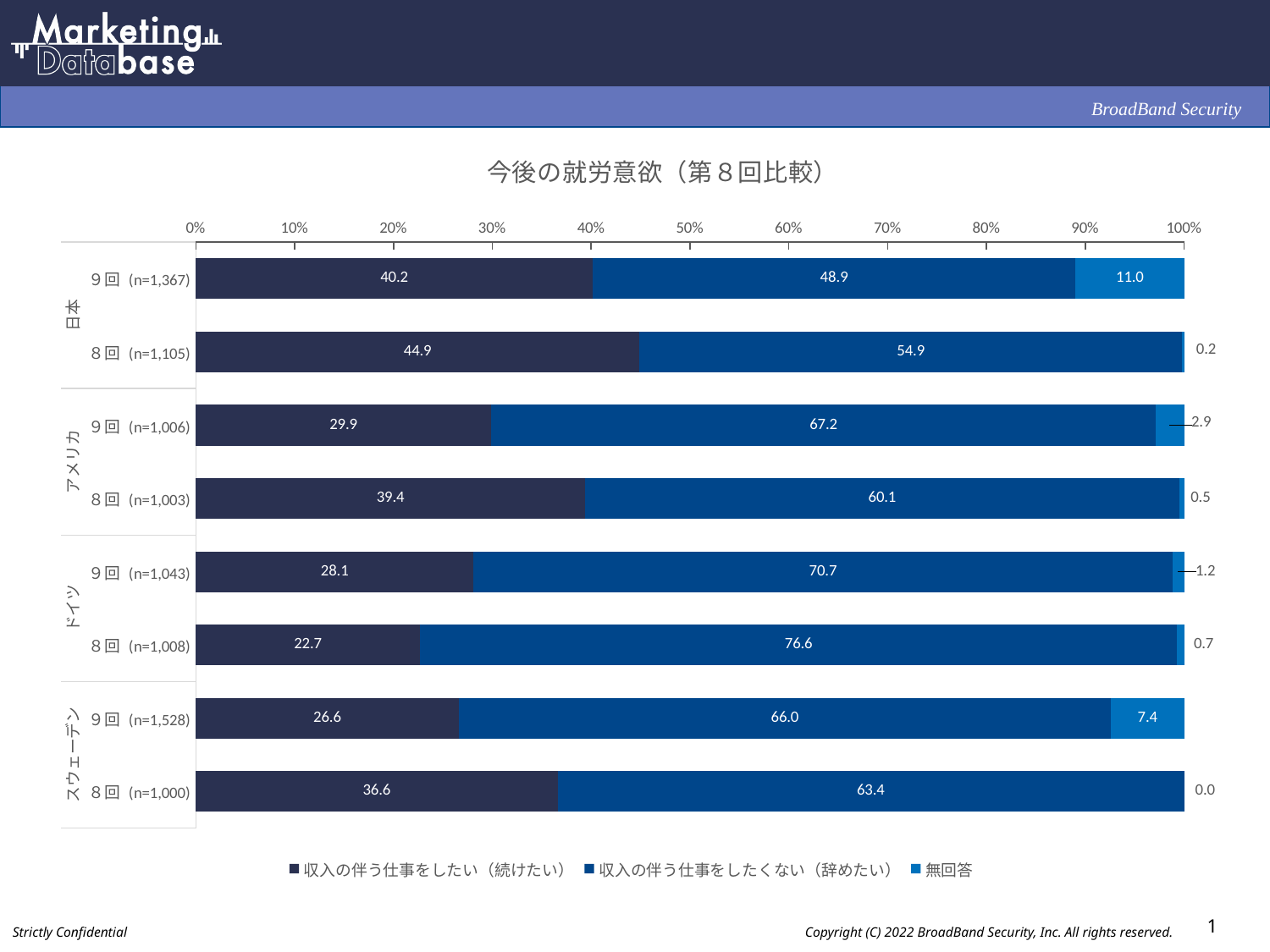
What is the value of 無回答 for スウェーデン 9回 (n=1,528)? 7.4 What is the difference in 収入の伴う仕事をしたい（続けたい） between 日本 8回 (n=1,105) and 日本 9回 (n=1,367)? 4.7 How many series does the legend list? 3 How many bars are plotted in the chart? 8 What is the value of 無回答 for アメリカ 9回 (n=1,006)? 2.9 Which bar has the highest value for 収入の伴う仕事をしたい（続けたい）? 日本 8回 (n=1,105) Which is larger: 収入の伴う仕事をしたくない（辞めたい） for アメリカ 9回 (n=1,006) or for アメリカ 8回 (n=1,003)? アメリカ 9回 (n=1,006) What is the value of 収入の伴う仕事をしたくない（辞めたい） for ドイツ 8回 (n=1,008)? 76.6 What type of chart is shown on the slide? Stacked bar chart Which bar has the highest value for 無回答? 日本 9回 (n=1,367) Which bar has the lowest value for 収入の伴う仕事をしたい（続けたい）? ドイツ 8回 (n=1,008) What is the value of 収入の伴う仕事をしたい（続けたい） for 日本 9回 (n=1,367)? 40.2